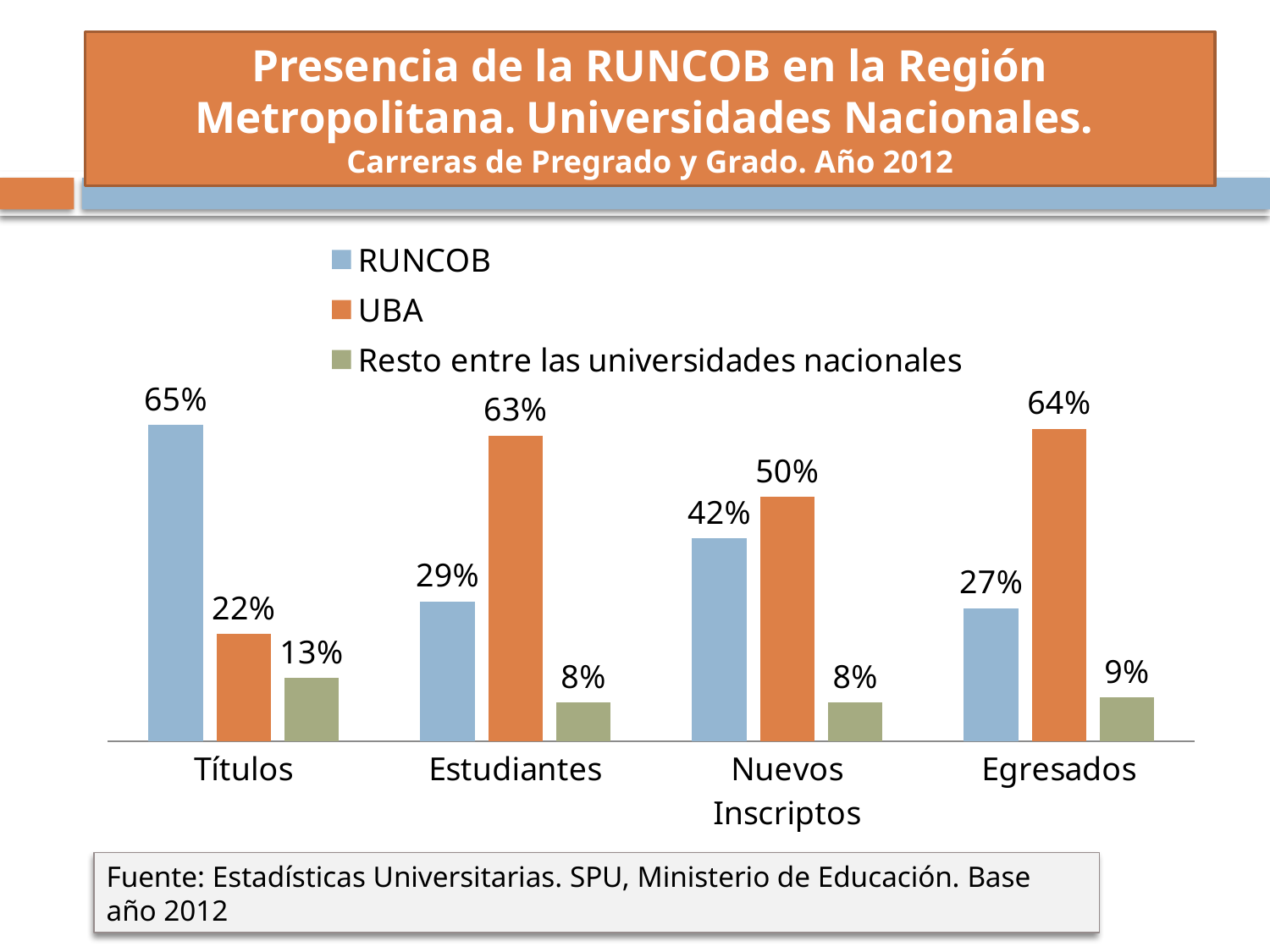
Which category has the highest RUNCOB value? Títulos How many series does the legend list? 3 What is the value for Resto entre las universidades nacionales for Egresados? 9% Which category has the lowest UBA value? Títulos What is the difference between the UBA and RUNCOB values for Egresados? 37 percentage points What kind of chart is shown on the slide? Bar chart For Nuevos Inscriptos, which is larger: the RUNCOB value or the UBA value? UBA What is the UBA value for Estudiantes? 63% Which series is shown in orange in the legend? UBA What is the RUNCOB value for Nuevos Inscriptos? 42% How many categories are shown on the x axis? 4 What is the RUNCOB value for Títulos? 65%